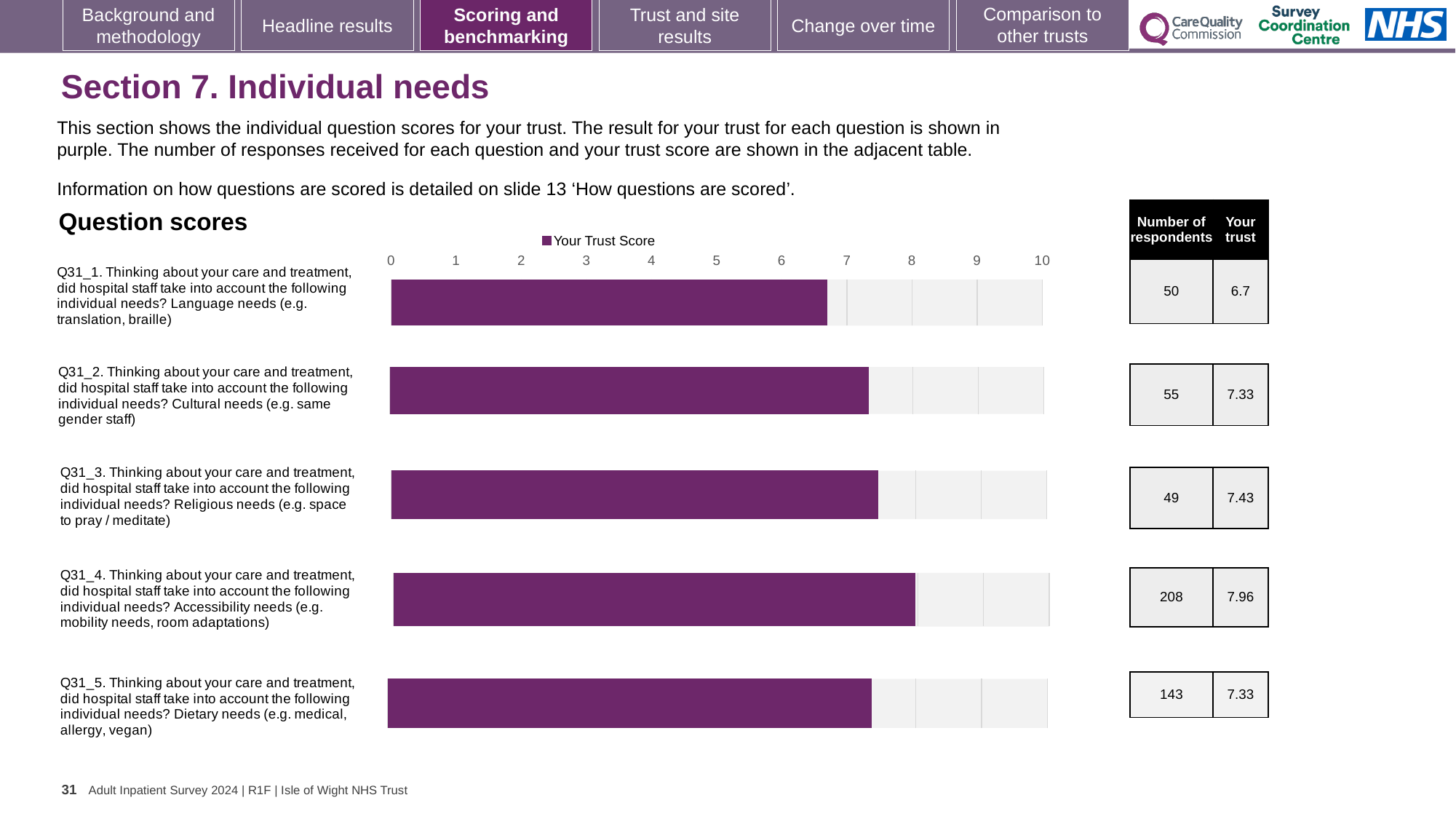
Which question has the lowest trust score? Q31_1 (Language needs) What is the trust score for Q31_3 (Religious needs)? 7.43 Is the value for Q31_1 (Language needs) greater or less than 7? less What is the trust score for Q31_1 (Language needs)? 6.7 How many series does the legend list? 1 What kind of chart is shown? Bar chart What is the difference between the trust scores for Q31_4 and Q31_1? 1.26 Is the value for Q31_4 (Accessibility needs) greater or less than 7? greater How many questions are plotted in the chart? 5 Which has the larger trust score, Q31_2 (Cultural needs) or Q31_4 (Accessibility needs)? Q31_4 (Accessibility needs) Which question has the highest trust score? Q31_4 (Accessibility needs) What is the trust score for Q31_4 (Accessibility needs)? 7.96